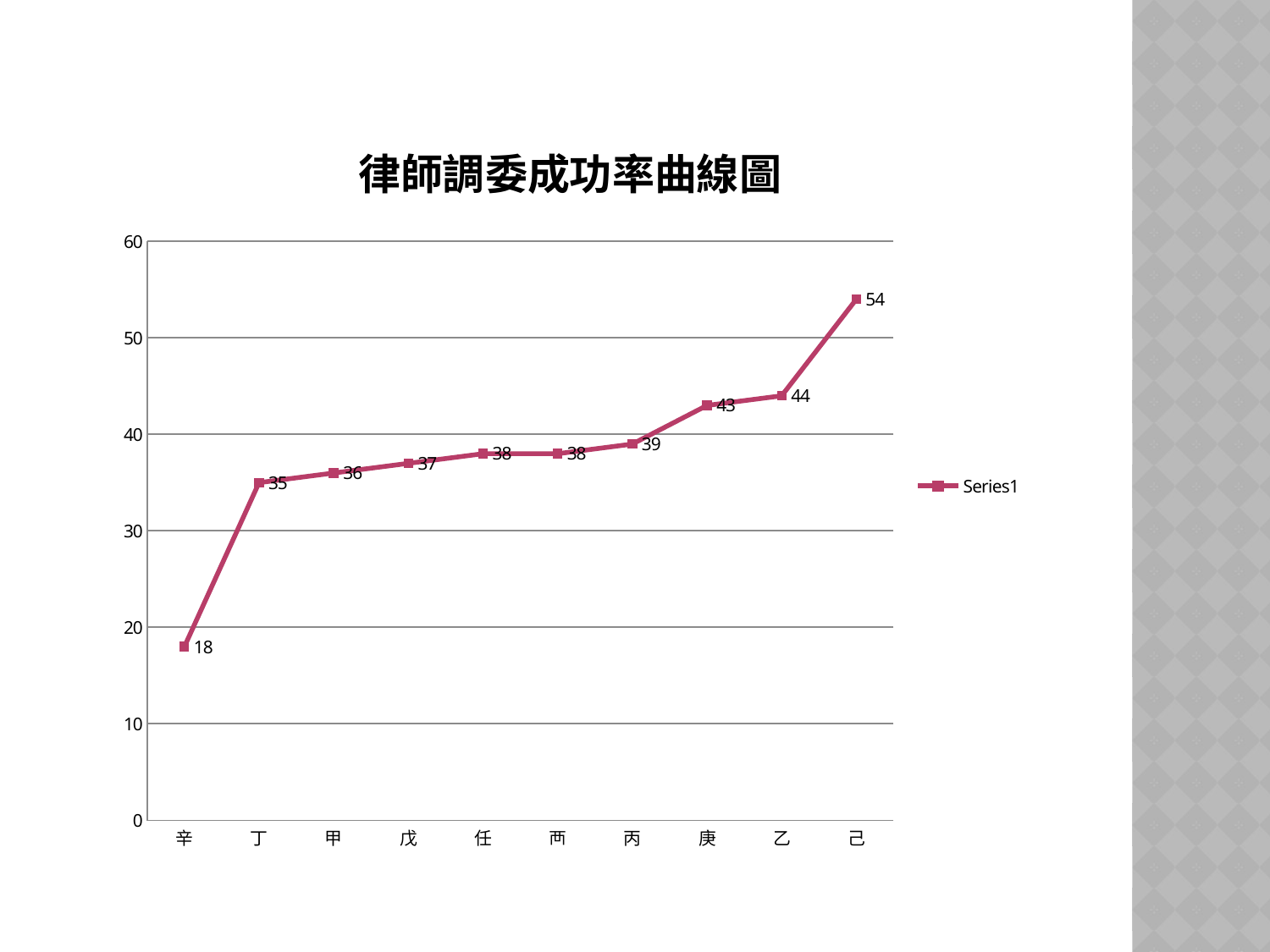
How many series does the legend list? 1 What is the value for 辛? 18 What is the difference between the values for 己 and 乙? 10 Do the values rise or fall from 辛 to 己 along the x axis? rise Which category has the highest value? 己 What is the difference between the values for 丁 and 辛? 17 What kind of chart is shown? line chart What is the value for 庚? 43 How many categories are plotted on the x axis? 10 Which is larger, the value for 甲 or the value for 庚? 庚 Which category has the lowest value? 辛 What is the value for 丙? 39